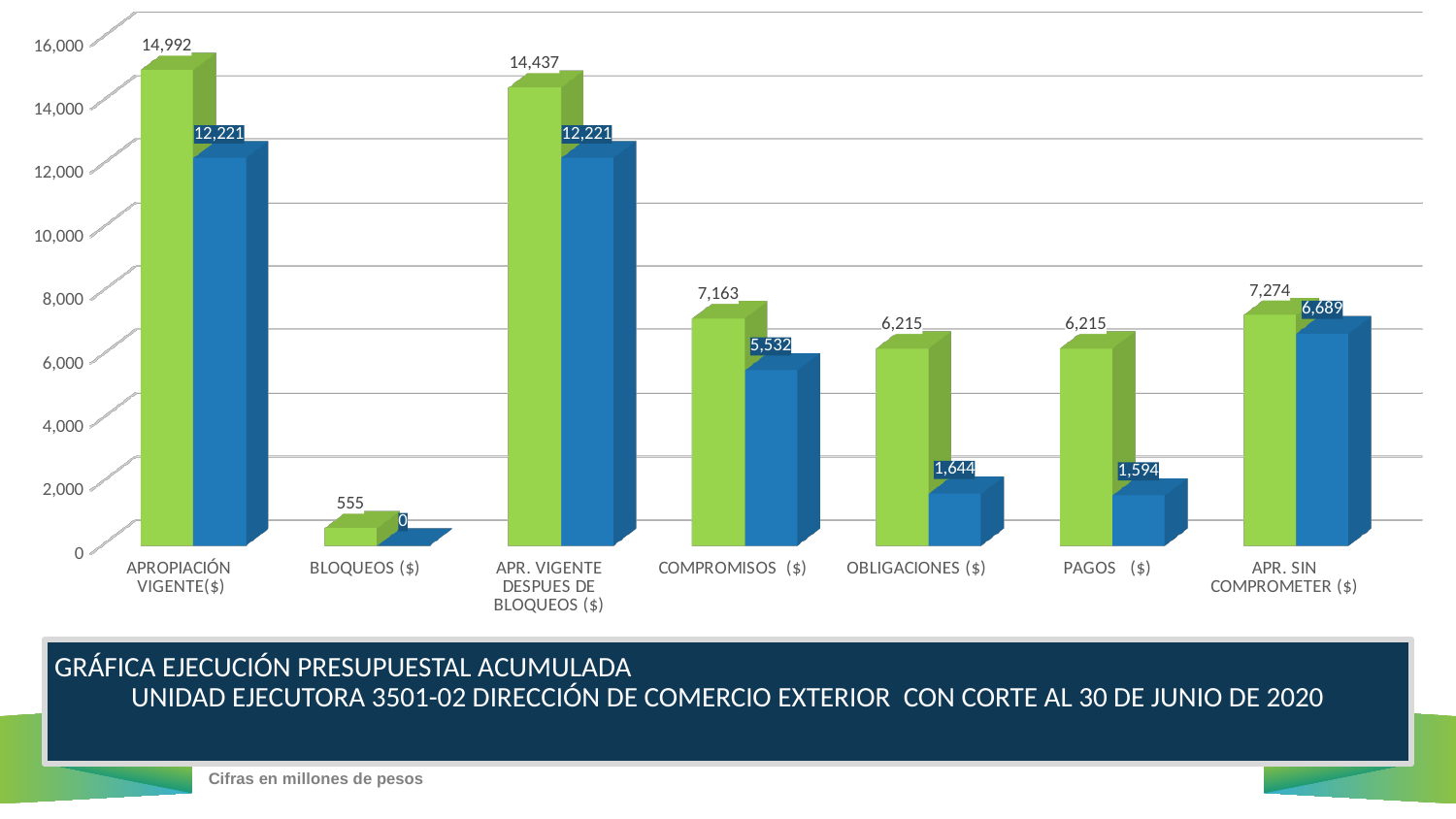
Which category has the highest green bar? APROPIACIÓN VIGENTE($) Which category has the lowest green bar? BLOQUEOS ($) How many categories are shown on the x axis? 7 According to the note below the chart, in what units are the figures expressed? Millones de pesos What is the value of the blue bar for BLOQUEOS ($)? 0 What kind of chart is shown on the slide? Bar chart What is the value of the green bar for APR. SIN COMPROMETER ($)? 7,274 What is the value of the blue bar for COMPROMISOS ($)? 5,532 What is the difference between the green bars for APROPIACIÓN VIGENTE($) and APR. VIGENTE DESPUES DE BLOQUEOS ($)? 555 What is the difference between the green and blue bars for OBLIGACIONES ($)? 4,571 What is the value of the green bar for APROPIACIÓN VIGENTE($)? 14,992 Which is larger, the blue bar for OBLIGACIONES ($) or the blue bar for PAGOS ($)? OBLIGACIONES ($)